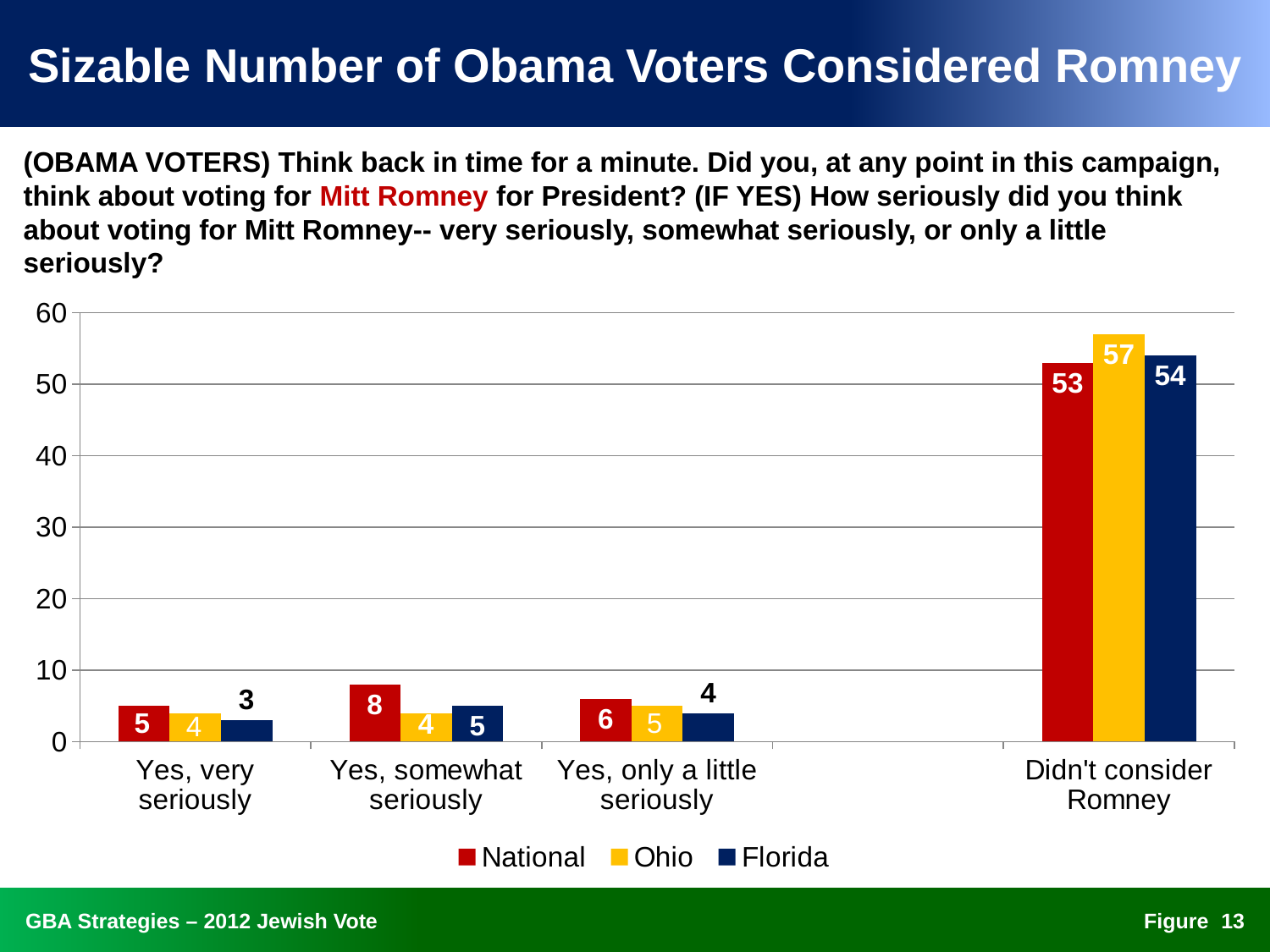
Which colour represents the Florida series? dark blue What is the National value for "Didn't consider Romney"? 53 Which series has the lowest value for "Yes, somewhat seriously"? Ohio What is the Florida value for "Yes, very seriously"? 3 How many series does the legend list? 3 Which series has the highest value for "Didn't consider Romney"? Ohio Which is larger: the National value for "Yes, somewhat seriously" or the National value for "Yes, only a little seriously"? Yes, somewhat seriously What is the difference between the Ohio and National values for "Didn't consider Romney"? 4 What is the Ohio value for "Yes, somewhat seriously"? 4 How many categories are shown on the x axis? 4 Is the Florida value for "Didn't consider Romney" greater or less than 50? greater What kind of chart is shown on the slide? bar chart